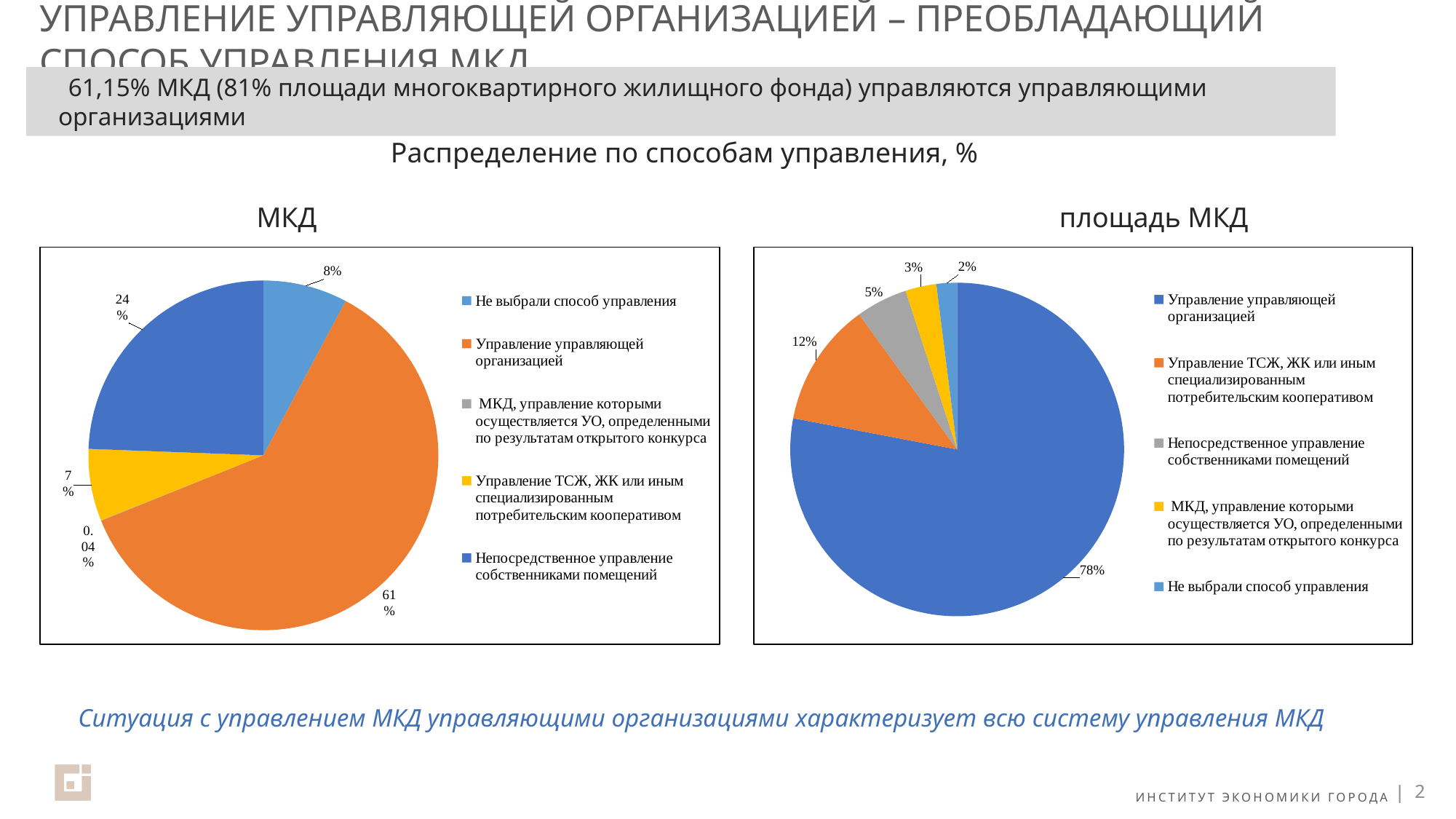
What type of chart is the "МКД" chart on the left? Pie chart In the "МКД" pie chart, what share is labelled for "Непосредственное управление собственниками помещений"? 24% In the "МКД" pie chart, what share is labelled for "Управление ТСЖ, ЖК или иным специализированным потребительским кооперативом"? 7% In the "МКД" pie chart, what share is labelled for "Управление управляющей организацией"? 61% In the "площадь МКД" pie chart, what is the difference in percentage points between the "Управление управляющей организацией" slice and the "Управление ТСЖ, ЖК или иным специализированным потребительским кооперативом" slice? 66 In the "площадь МКД" pie chart, which category has the smallest slice? Не выбрали способ управления In the "площадь МКД" pie chart, what share is labelled for "Управление управляющей организацией"? 78% In the "МКД" pie chart, which category has the largest slice? Управление управляющей организацией In the "МКД" pie chart, which is larger: the slice for "Непосредственное управление собственниками помещений" or the slice for "Не выбрали способ управления"? Непосредственное управление собственниками помещений How many categories does the legend of the "площадь МКД" pie chart list? 5 In the "площадь МКД" pie chart, what share is labelled for "Управление ТСЖ, ЖК или иным специализированным потребительским кооперативом"? 12% In the "МКД" pie chart, what share is labelled for "Не выбрали способ управления"? 8%